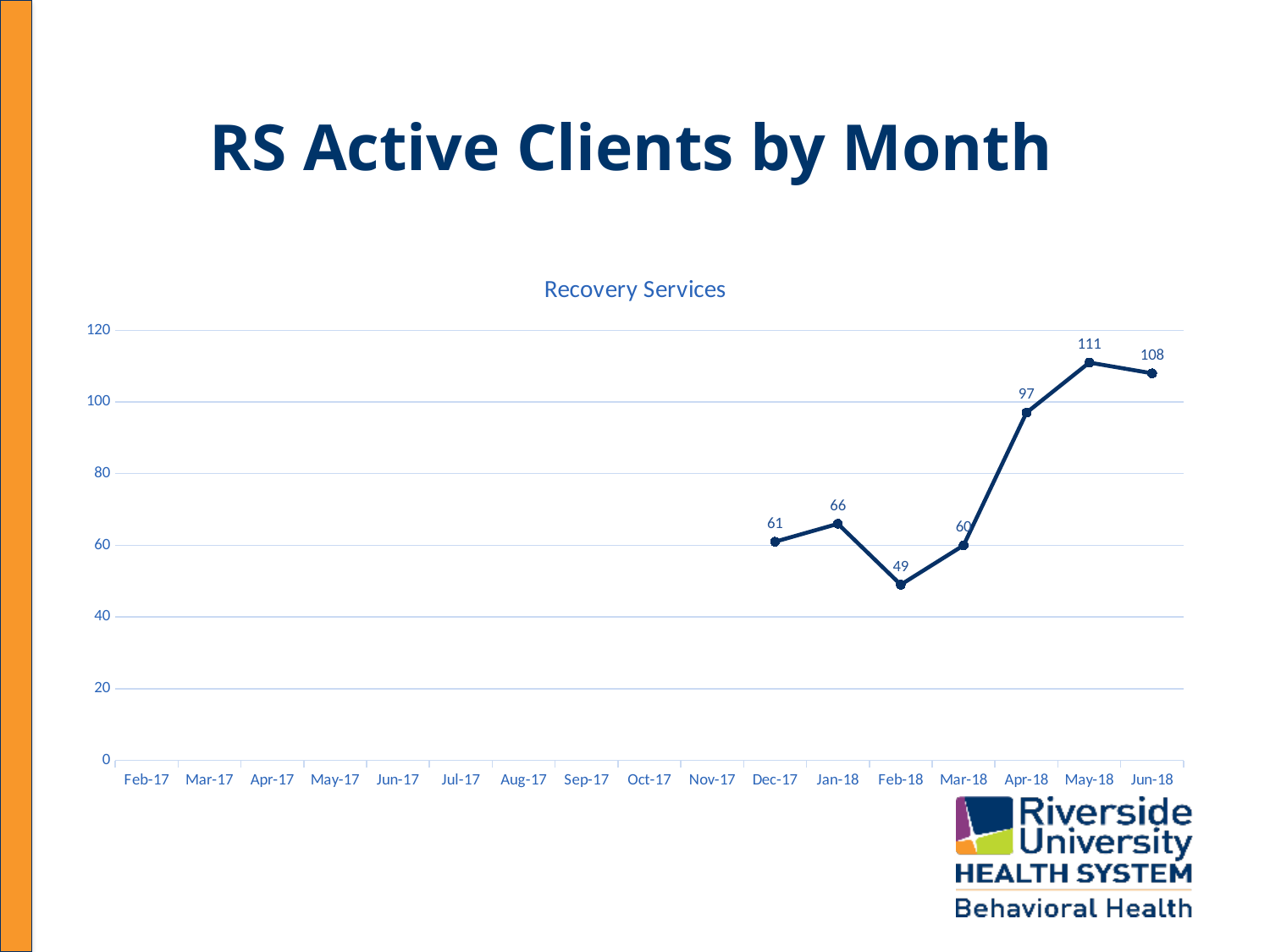
What kind of chart is shown? line chart Is the value for Apr-18 greater or less than 80? greater What is the difference between the values for May-18 and Apr-18? 14 What is the value for Feb-18? 49 How many data points are plotted on the line? 7 Which month has the highest value? May-18 What is the value for Jun-18? 108 What is the value for Apr-18? 97 Which month has the lowest plotted value? Feb-18 What is the value for Dec-17? 61 What is the title of the chart? Recovery Services Which is larger, the value for Jan-18 or the value for Mar-18? Jan-18